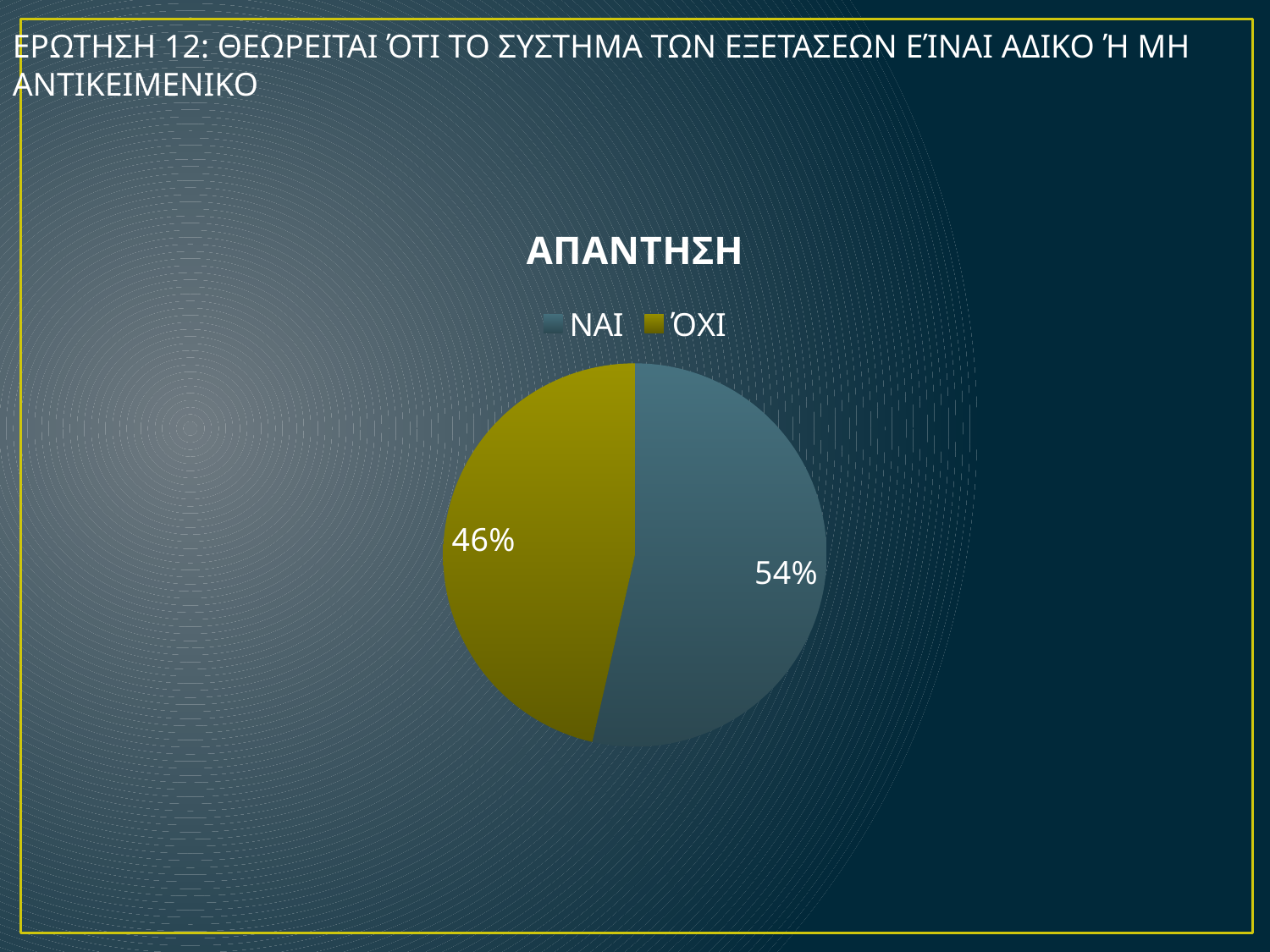
Which category has the largest share of the pie chart? ΝΑΙ How many entries does the legend list? 2 Which category has the smallest share of the pie chart? ΌΧΙ How many categories does the pie chart show? 2 What is the difference in percentage points between ΝΑΙ and ΌΧΙ? 8 Which colour represents ΌΧΙ in the pie chart? yellow Which is larger, the share for ΝΑΙ or the share for ΌΧΙ? ΝΑΙ What is the share of the pie taken by ΝΑΙ? 54% What percentage of the pie chart is ΌΧΙ? 46% What is the title of the chart? ΑΠΑΝΤΗΣΗ What percentage of the pie chart is ΝΑΙ? 54% What kind of chart is shown on the slide? pie chart